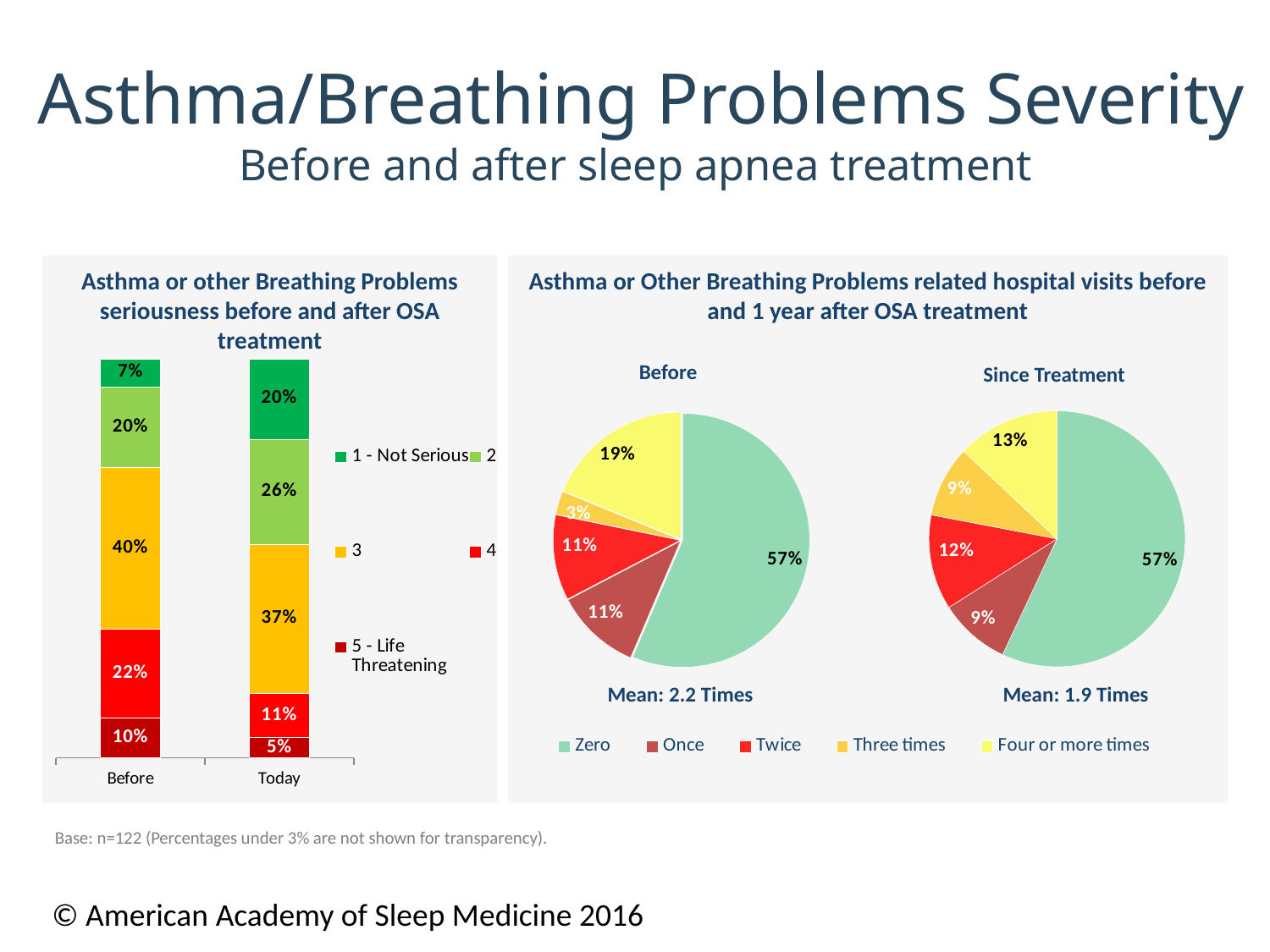
In the 'Before' pie chart, which category has the smallest slice? Three times What kind of chart is the chart on the left of the slide? Stacked bar chart In the stacked bar chart on the left, what is the value for category 3 in the Before bar? 40% What mean number of hospital visits is shown under the 'Before' pie chart? 2.2 Times In the stacked bar chart on the left, by how many percentage points does '1 - Not Serious' differ between Today and Before? 13 percentage points In the 'Since Treatment' pie chart, which category has the largest slice? Zero How many series does the legend of the stacked bar chart on the left list? 5 In the 'Since Treatment' pie chart, what is the value for 'Three times'? 9% Is the 'Twice' value larger in the 'Before' pie chart or the 'Since Treatment' pie chart? Since Treatment What is the difference between the 'Four or more times' values in the 'Before' and 'Since Treatment' pie charts? 6 percentage points In the 'Before' pie chart, what share of respondents had four or more hospital visits? 19% In the stacked bar chart on the left, what is the value for '5 - Life Threatening' in the Today bar? 5%